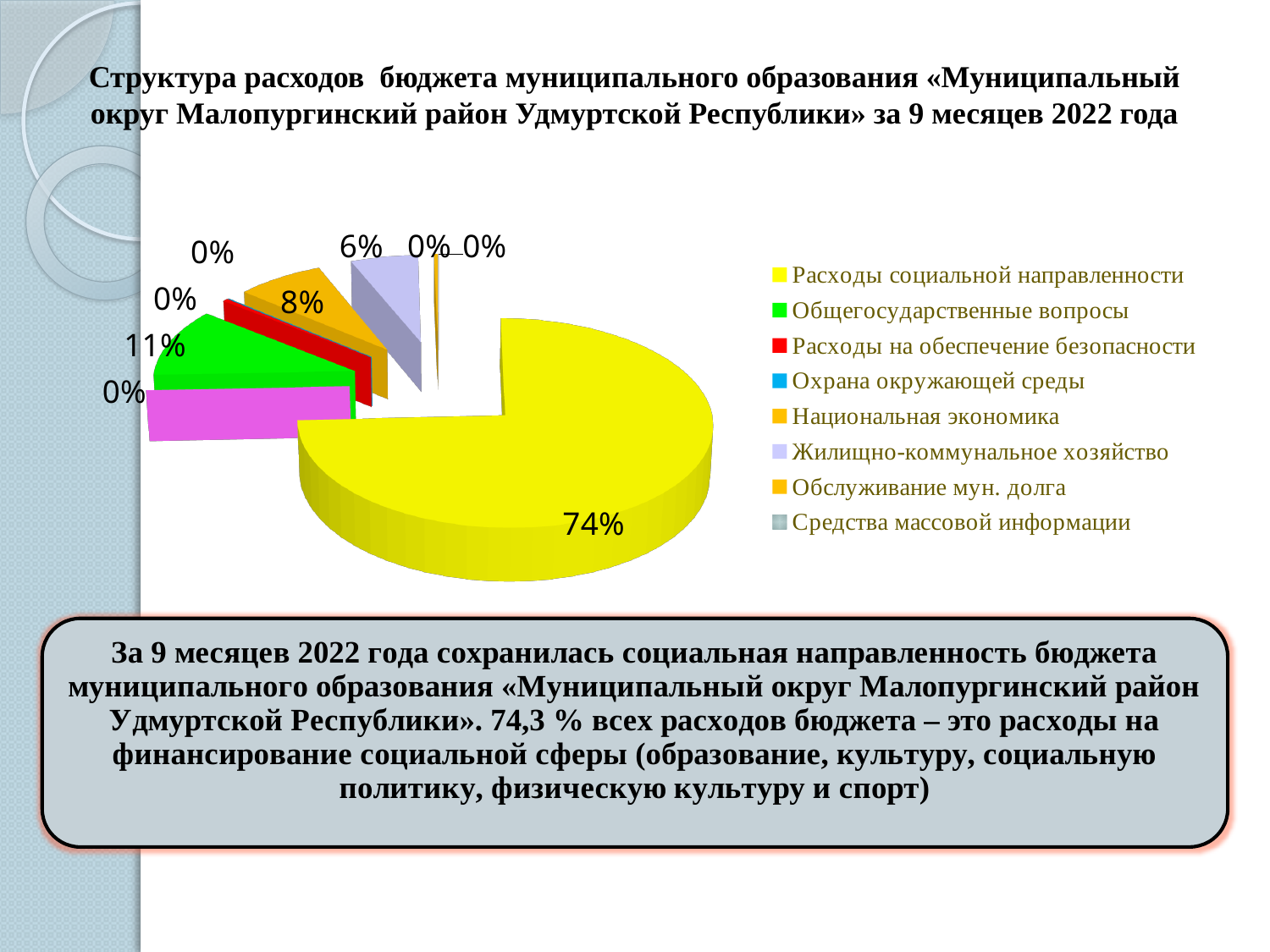
Which is larger: the slice for Общегосударственные вопросы or the slice for Жилищно-коммунальное хозяйство? Общегосударственные вопросы Which category has the largest slice of the pie? Расходы социальной направленности How many entries does the legend list? 8 What kind of chart is shown on the slide? pie chart What is the difference in percentage points between the 74% slice and the 11% slice? 63% What colour is the slice for Расходы социальной направленности? yellow What percentage is shown for the orange slice (Национальная экономика)? 8% What percentage is shown for the light purple slice (Жилищно-коммунальное хозяйство)? 6% Is the share for Национальная экономика greater or less than 50%? less Which legend entry is shown in red? Расходы на обеспечение безопасности What percentage is shown for the green slice (Общегосударственные вопросы)? 11% What share of the budget expenditures is labelled for Расходы социальной направленности? 74%